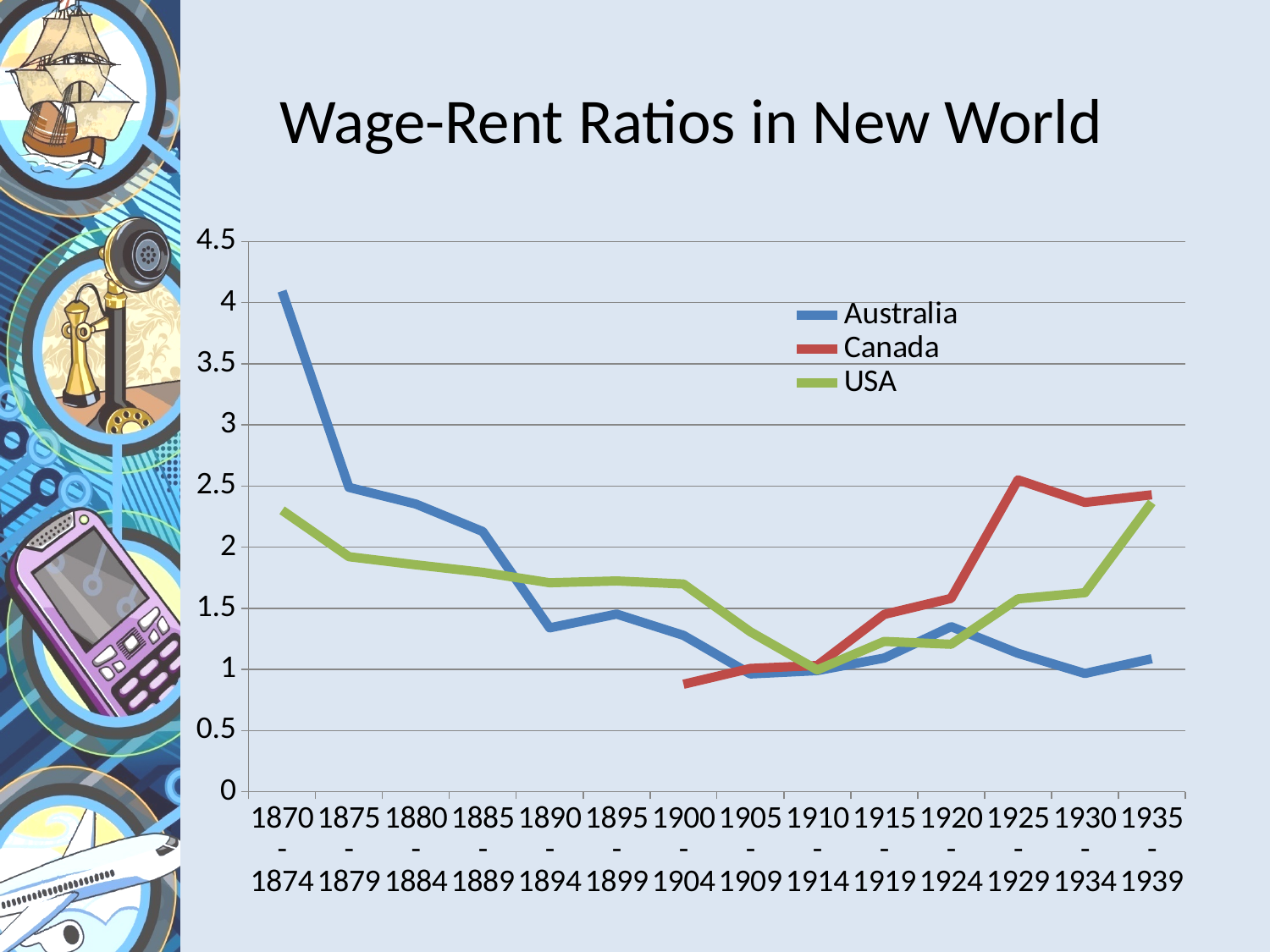
How many series does the legend list? 3 Does the Australia line rise or fall from 1870-1874 to 1890-1894? Fall Which series has the highest value in 1870-1874? Australia Which series only begins at 1900-1904 rather than 1870-1874? Canada How many time periods are shown on the x axis? 14 Is the value for Australia in 1870-1874 greater or less than 3.5? greater In 1930-1934, which is larger, the value for Canada or the value for USA? Canada What kind of chart is shown on the slide? Line chart Is the value for Canada in 1900-1904 greater or less than 1? less Is the value for Australia in 1935-1939 greater or less than 1.5? less Which series has the lowest value in 1935-1939? Australia